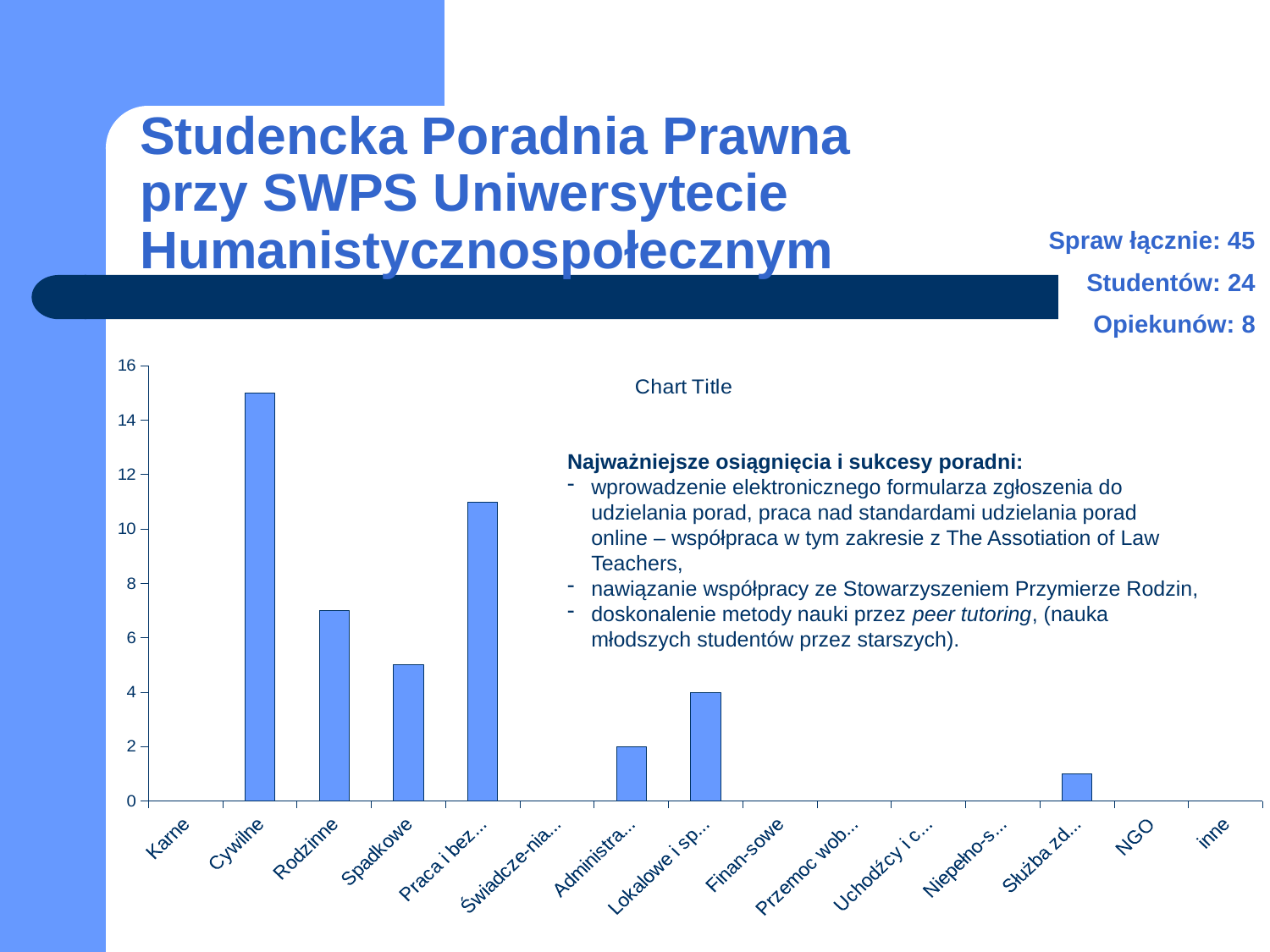
How many categories are shown on the x axis of the chart? 15 Is the value for Praca i bez... greater or less than 10? greater What is the value for Lokalowe i sp... in the chart? 4 Which category has the highest bar in the chart? Cywilne Is the value for Cywilne greater or less than 14? greater What kind of chart is shown on the slide? bar chart Which is larger, the value for Rodzinne or the value for Spadkowe? Rodzinne Is the value for Rodzinne greater or less than 8? less What is the difference between the values for Lokalowe i sp... and Administra...? 2 What is the value for Administra... in the chart? 2 What is the value for Karne in the chart? 0 What title is displayed on the chart? Chart Title